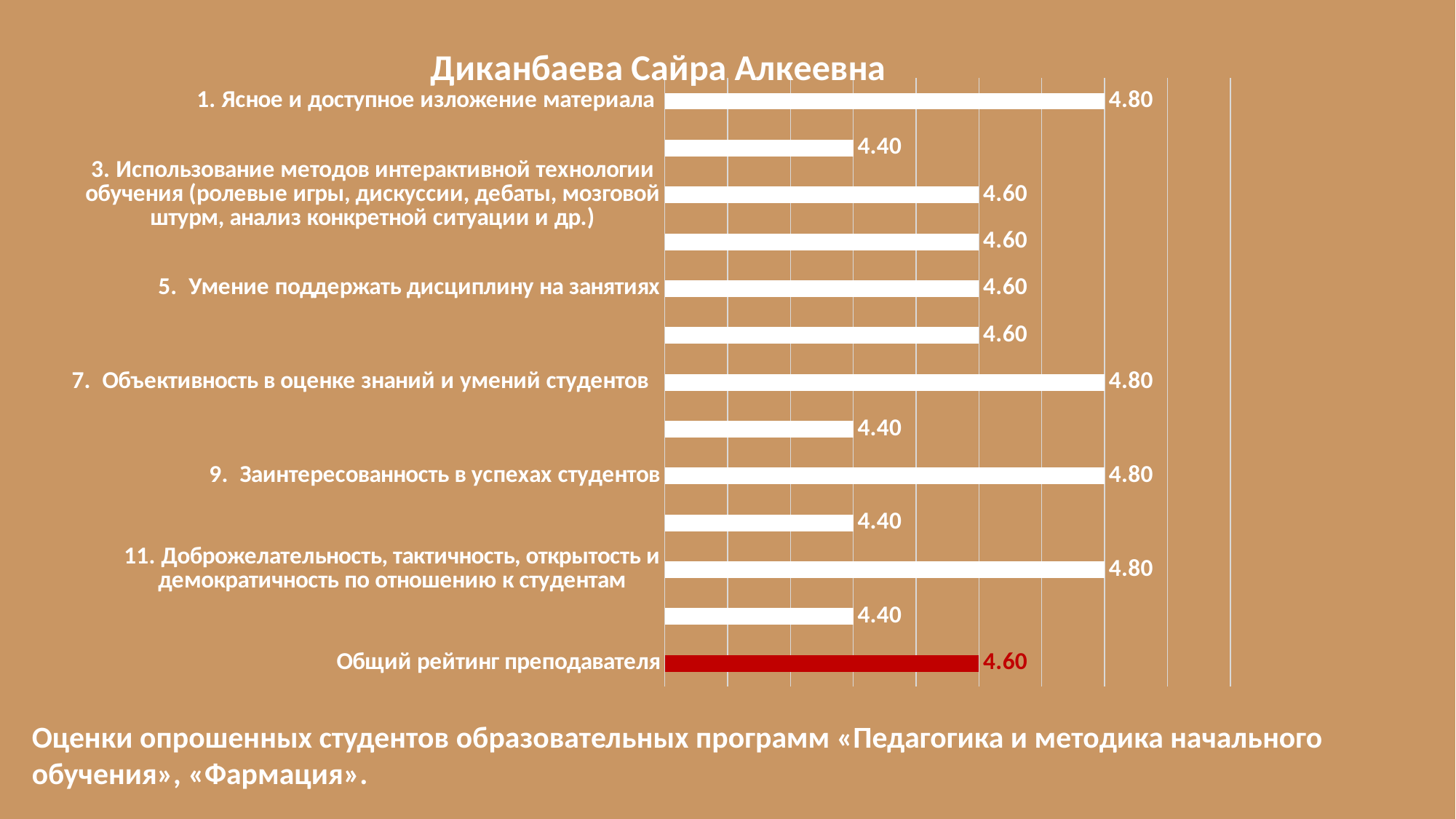
What is the value for "7. Объективность в оценке знаний и умений студентов"? 4.80 What is the difference between the value for "1. Ясное и доступное изложение материала" and the value for "Общий рейтинг преподавателя"? 0.20 What is the value for "9. Заинтересованность в успехах студентов"? 4.80 Which bar in the chart is coloured red rather than white? Общий рейтинг преподавателя What is the value for "5. Умение поддержать дисциплину на занятиях"? 4.60 What is the value for "Общий рейтинг преподавателя"? 4.60 What is the value for "11. Доброжелательность, тактичность, открытость и демократичность по отношению к студентам"? 4.80 What is the title of the chart? Диканбаева Сайра Алкеевна What is the value for "1. Ясное и доступное изложение материала"? 4.80 How many bars are plotted in the chart? 13 What kind of chart is shown on the slide? Bar chart Which is larger: the value for "9. Заинтересованность в успехах студентов" or the value for "Общий рейтинг преподавателя"? 9. Заинтересованность в успехах студентов